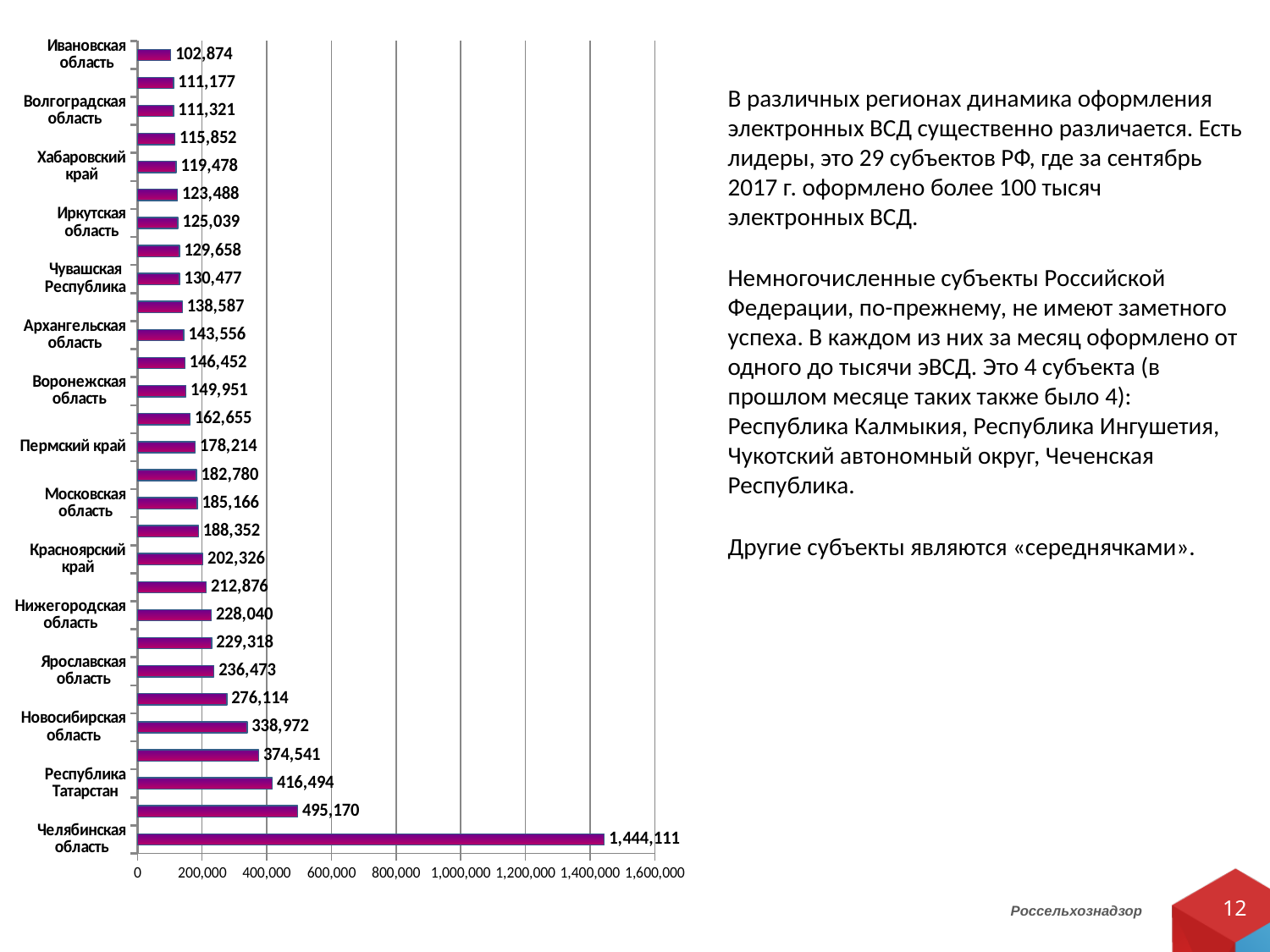
How many bars are plotted in the chart? 29 Which region has the lowest value? Ивановская область What is the value for Республика Татарстан? 416,494 What is the value for Московская область? 185,166 What is the value for Хабаровский край? 119,478 Which is larger, the value for Новосибирская область or the value for Ярославская область? Новосибирская область What is the difference between the values for Челябинская область and Республика Татарстан? 1,027,617 Is the value for Красноярский край greater or less than 200,000? greater What kind of chart is shown on the slide? bar chart Which region has the highest value? Челябинская область What is the difference between the values for Пермский край and Воронежская область? 28,263 What is the value for Челябинская область? 1,444,111